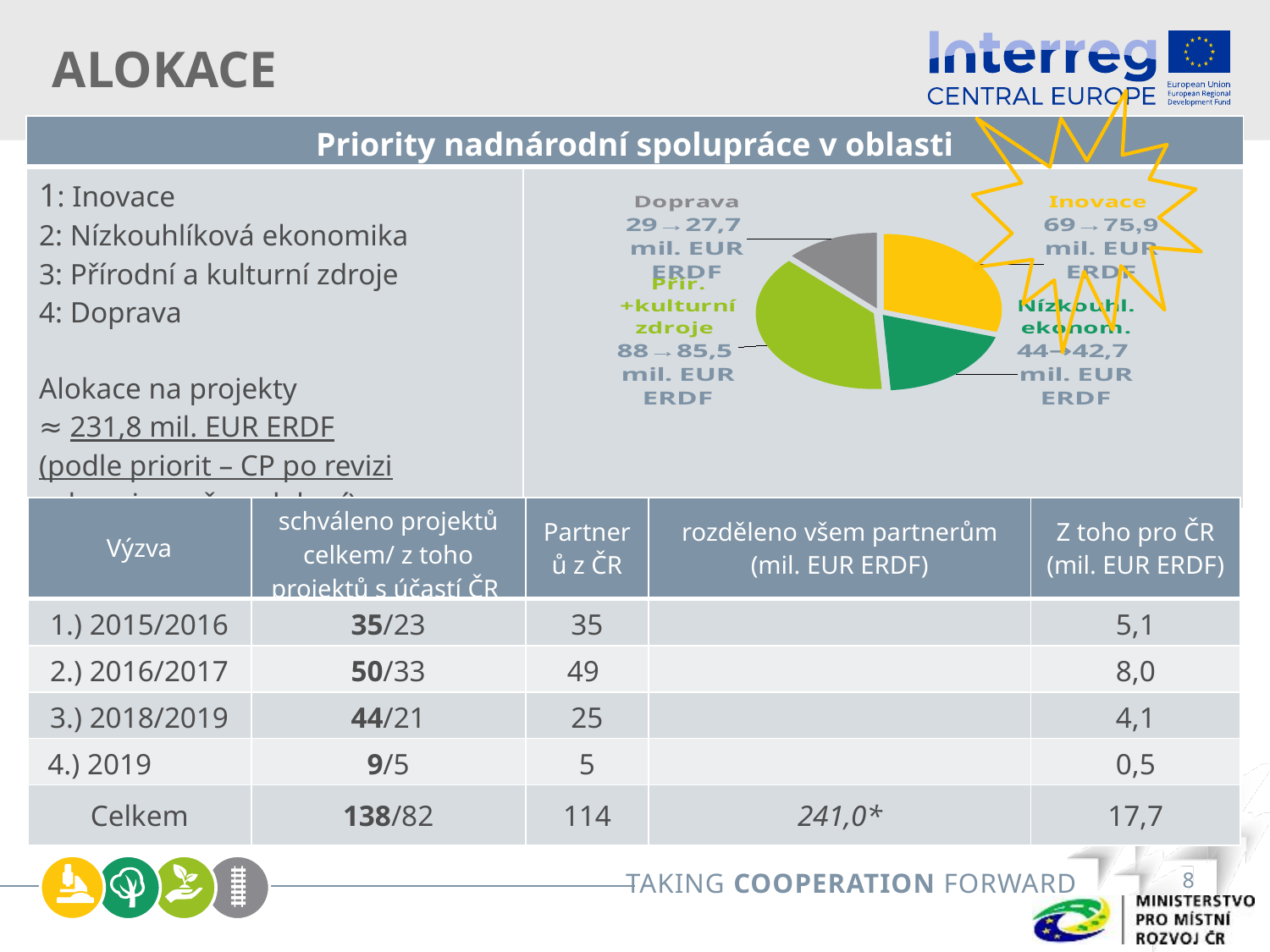
What is the difference between the revised allocations for Přír.+kulturní zdroje and Doprava in the pie chart? 57,8 mil. EUR ERDF Which priority has the smallest revised allocation in the pie chart? Doprava What kind of chart is shown on the slide? pie chart Which slice of the pie chart is coloured grey? Doprava What revised allocation (after the arrow) does the pie chart label show for Nízkouhl. ekonom.? 42,7 mil. EUR ERDF What revised allocation (after the arrow) does the pie chart label show for Inovace? 75,9 mil. EUR ERDF What original allocation (before the arrow) does the pie chart label show for Inovace? 69 How many slices does the pie chart have? 4 What revised allocation (after the arrow) does the pie chart label show for Přír.+kulturní zdroje? 85,5 mil. EUR ERDF What revised allocation (after the arrow) does the pie chart label show for Doprava? 27,7 mil. EUR ERDF Which priority has the largest revised allocation in the pie chart? Přír.+kulturní zdroje Which has a larger revised allocation in the pie chart, Inovace or Nízkouhl. ekonom.? Inovace